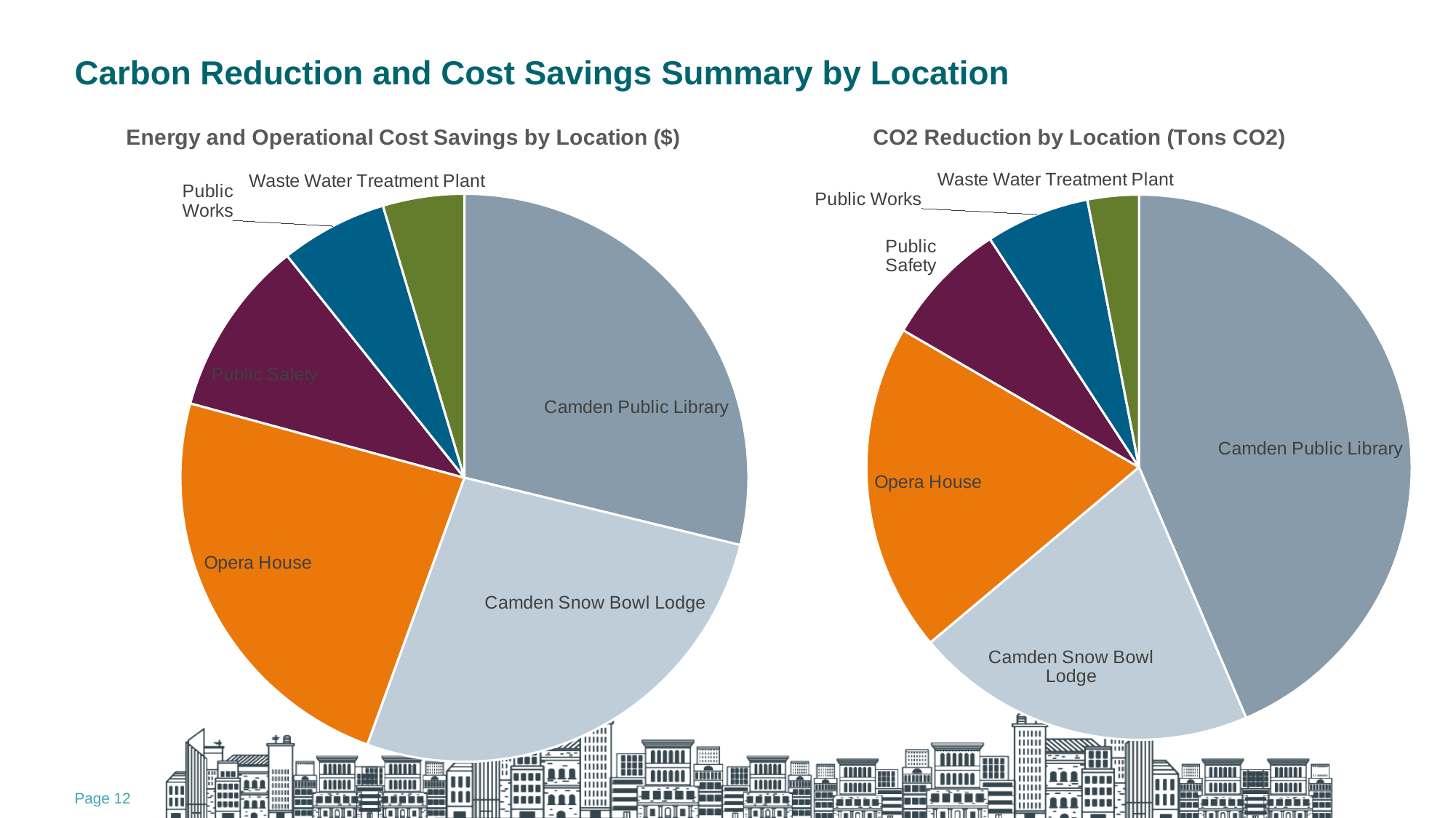
In the 'Energy and Operational Cost Savings by Location ($)' chart, which slice is larger: Public Safety or Public Works? Public Safety In the 'CO2 Reduction by Location (Tons CO2)' chart, what colour is the Opera House slice? orange How many locations are shown in the 'CO2 Reduction by Location (Tons CO2)' pie chart? 6 In the 'CO2 Reduction by Location (Tons CO2)' chart, which location has the largest slice? Camden Public Library In the 'CO2 Reduction by Location (Tons CO2)' chart, which slice is larger: Public Works or Waste Water Treatment Plant? Public Works In the 'CO2 Reduction by Location (Tons CO2)' chart, which slice is larger: Opera House or Public Safety? Opera House How many locations are shown in the 'Energy and Operational Cost Savings by Location ($)' pie chart? 6 In the 'CO2 Reduction by Location (Tons CO2)' chart, which location has the smallest slice? Waste Water Treatment Plant What is the title of the pie chart on the left of the slide? Energy and Operational Cost Savings by Location ($) What kind of chart is the 'Energy and Operational Cost Savings by Location ($)' chart? pie chart What kind of chart is the 'CO2 Reduction by Location (Tons CO2)' chart? pie chart